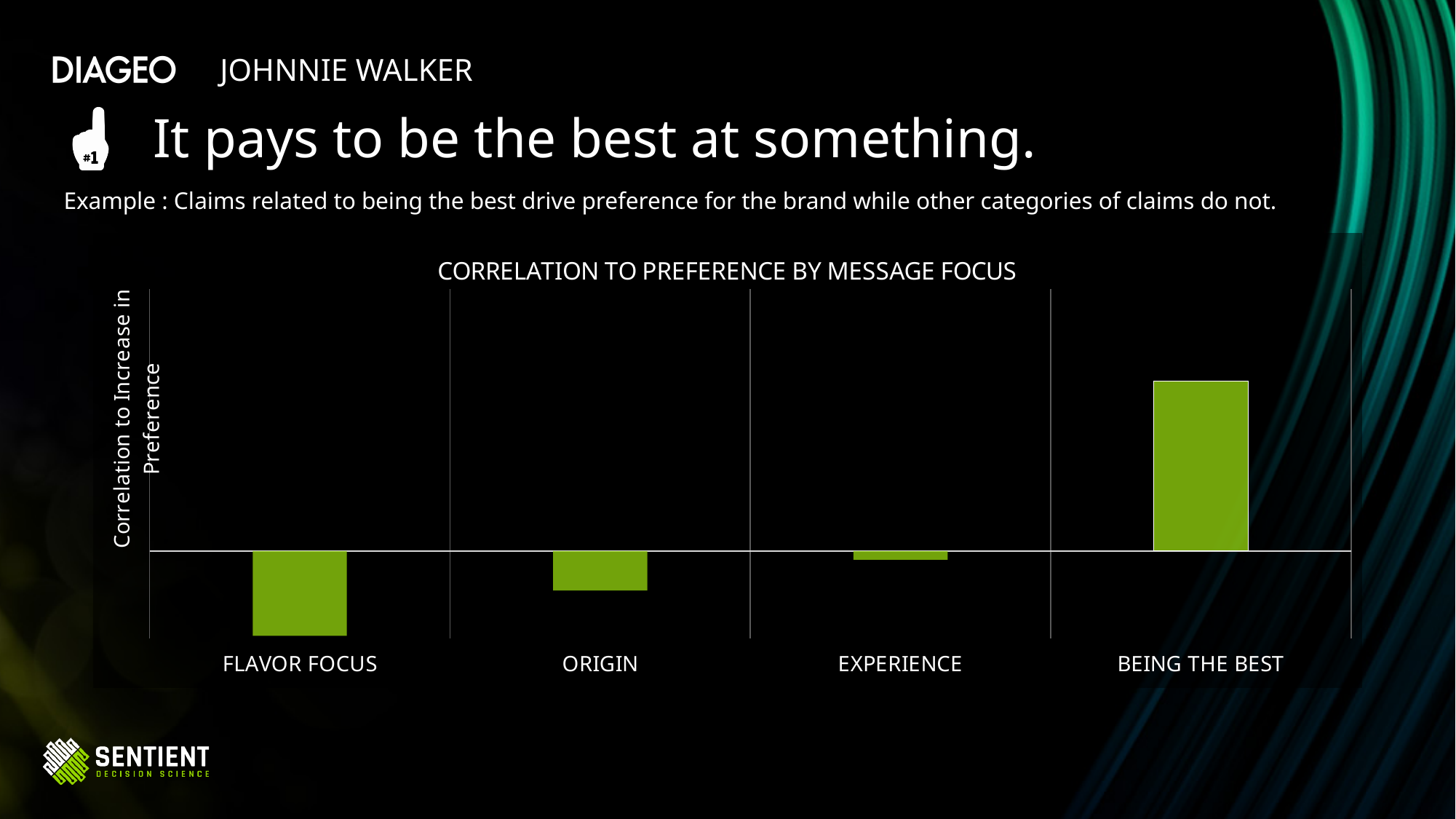
Which message focus has the lowest correlation to increase in preference? FLAVOR FOCUS Do the values rise or fall moving from FLAVOR FOCUS to BEING THE BEST along the x axis? Rise What is the title of the chart? CORRELATION TO PREFERENCE BY MESSAGE FOCUS Which is the only category with a positive correlation to increase in preference? BEING THE BEST Which is larger, the value for FLAVOR FOCUS or the value for ORIGIN? ORIGIN What is the label on the vertical axis of the chart? Correlation to Increase in Preference Which is larger, the value for EXPERIENCE or the value for ORIGIN? EXPERIENCE What kind of chart is shown on the slide? Bar chart Which message focus has the highest correlation to increase in preference? BEING THE BEST Which is larger, the value for BEING THE BEST or the value for EXPERIENCE? BEING THE BEST How many message focus categories are shown on the chart? 4 How many categories on the chart have a negative correlation value? 3